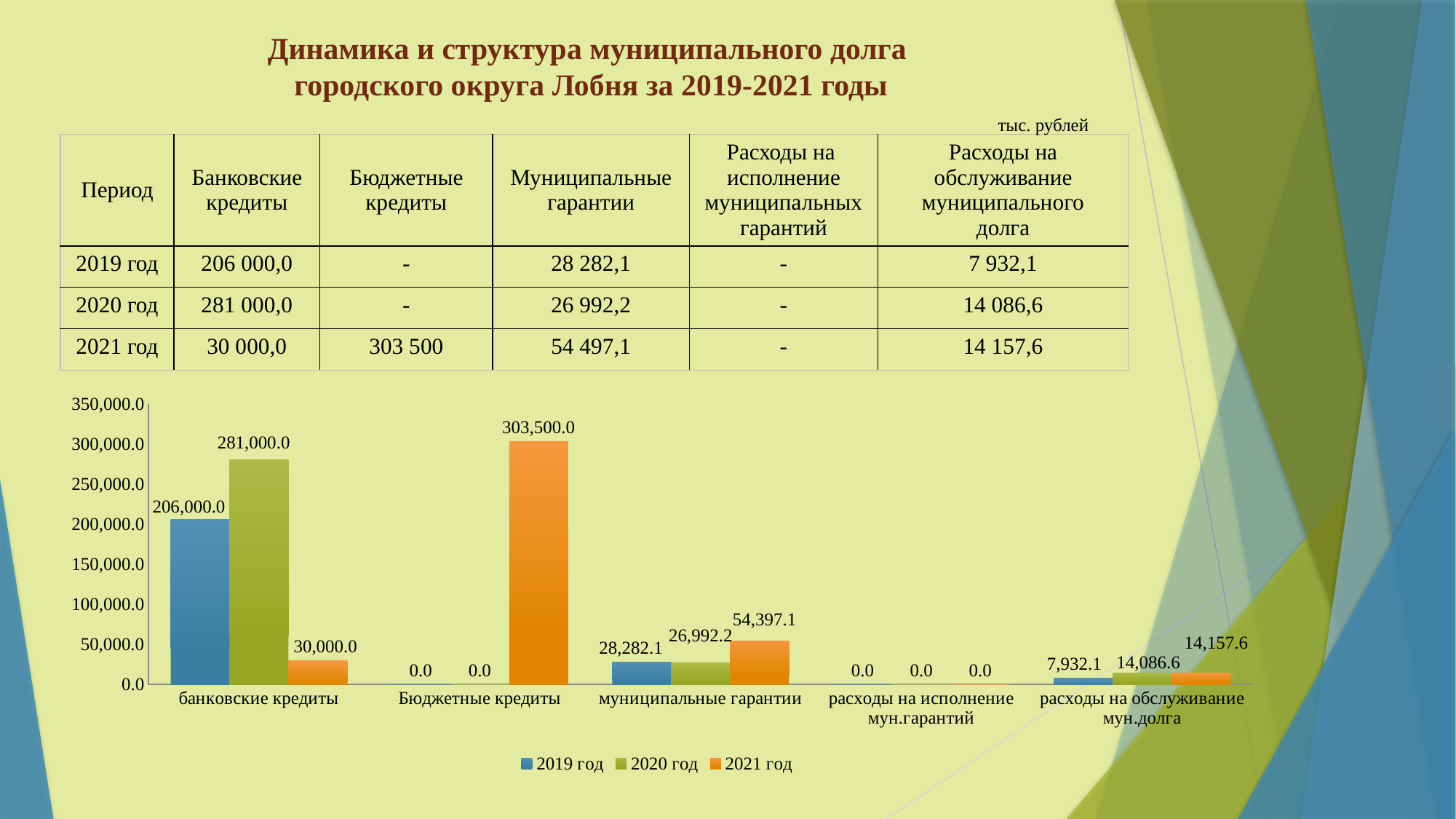
Which category has the highest value for the 2020 год series on the chart? банковские кредиты How many series does the chart legend list? 3 What is the value for банковские кредиты in 2019 год on the chart? 206,000.0 What is the value for Бюджетные кредиты in 2021 год on the chart? 303,500.0 What is the value for расходы на обслуживание мун.долга in 2019 год on the chart? 7,932.1 What kind of chart is shown on the slide? bar chart What is the value for муниципальные гарантии in 2020 год on the chart? 26,992.2 Is the value for банковские кредиты in 2021 год greater or less than 50,000.0 on the chart? less Which is larger on the chart: муниципальные гарантии in 2019 год or in 2021 год? 2021 год Which category has the highest value for the 2021 год series on the chart? Бюджетные кредиты How many categories are shown on the x axis of the chart? 5 What is the difference between the 2020 год and 2019 год values for банковские кредиты on the chart? 75,000.0